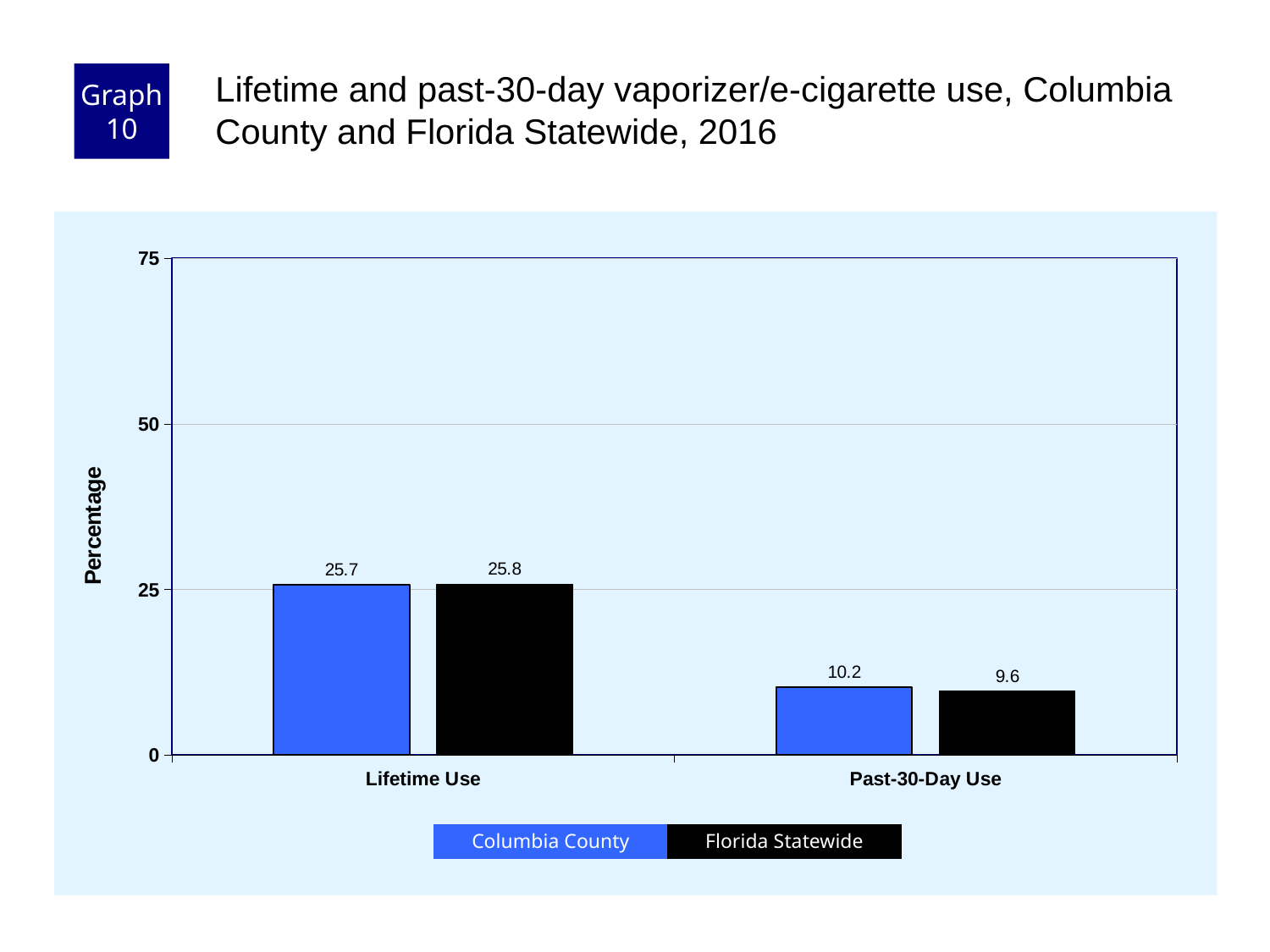
What is the difference between the Columbia County and Florida Statewide values for Past-30-Day Use? 0.6 What is the Florida Statewide value for Past-30-Day Use? 9.6 What is the Florida Statewide value for Lifetime Use? 25.8 Which category has the highest Columbia County value? Lifetime Use Is the Florida Statewide value for Lifetime Use greater or less than 50? less What is the Columbia County value for Lifetime Use? 25.7 How many series does the legend list? 2 Which category has the lowest Florida Statewide value? Past-30-Day Use How many categories are shown on the x axis? 2 What is the Columbia County value for Past-30-Day Use? 10.2 What is the difference between the Columbia County values for Lifetime Use and Past-30-Day Use? 15.5 What kind of chart is shown on the slide? bar chart